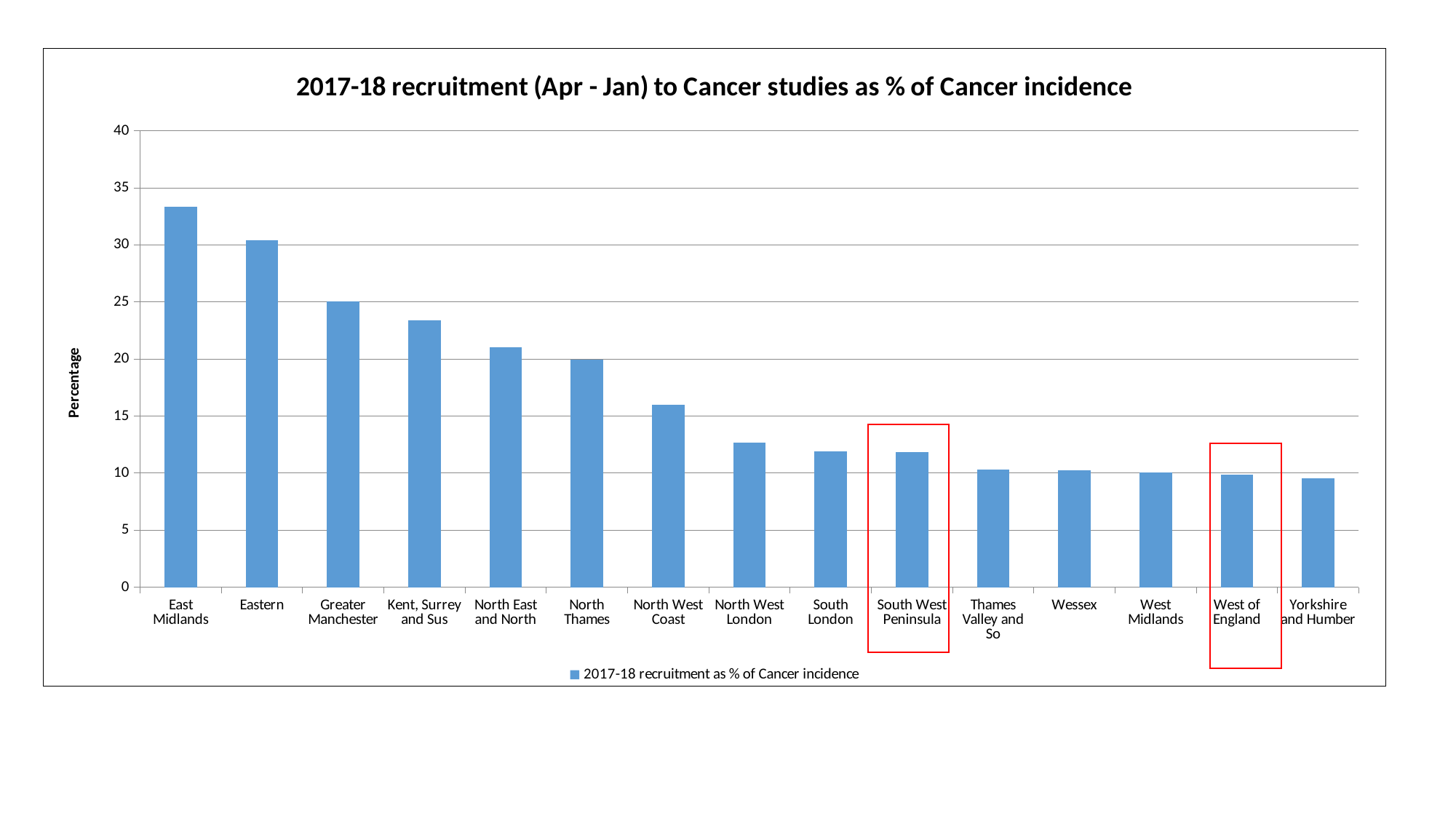
Which is larger, the value for East Midlands or the value for Eastern? East Midlands Is the value for East Midlands greater or less than 30? greater How many regions are shown on the x axis of the chart? 15 What kind of chart is shown on the slide? Bar chart Do the values rise or fall moving from left to right along the x axis? fall Is the value for North West Coast greater or less than 15? greater How many series does the legend list? 1 Is the value for Yorkshire and Humber greater or less than 10? less What is the title of the chart? 2017-18 recruitment (Apr - Jan) to Cancer studies as % of Cancer incidence Which is larger, the value for South West Peninsula or the value for West of England? South West Peninsula Which region has the highest 2017-18 recruitment as % of cancer incidence? East Midlands